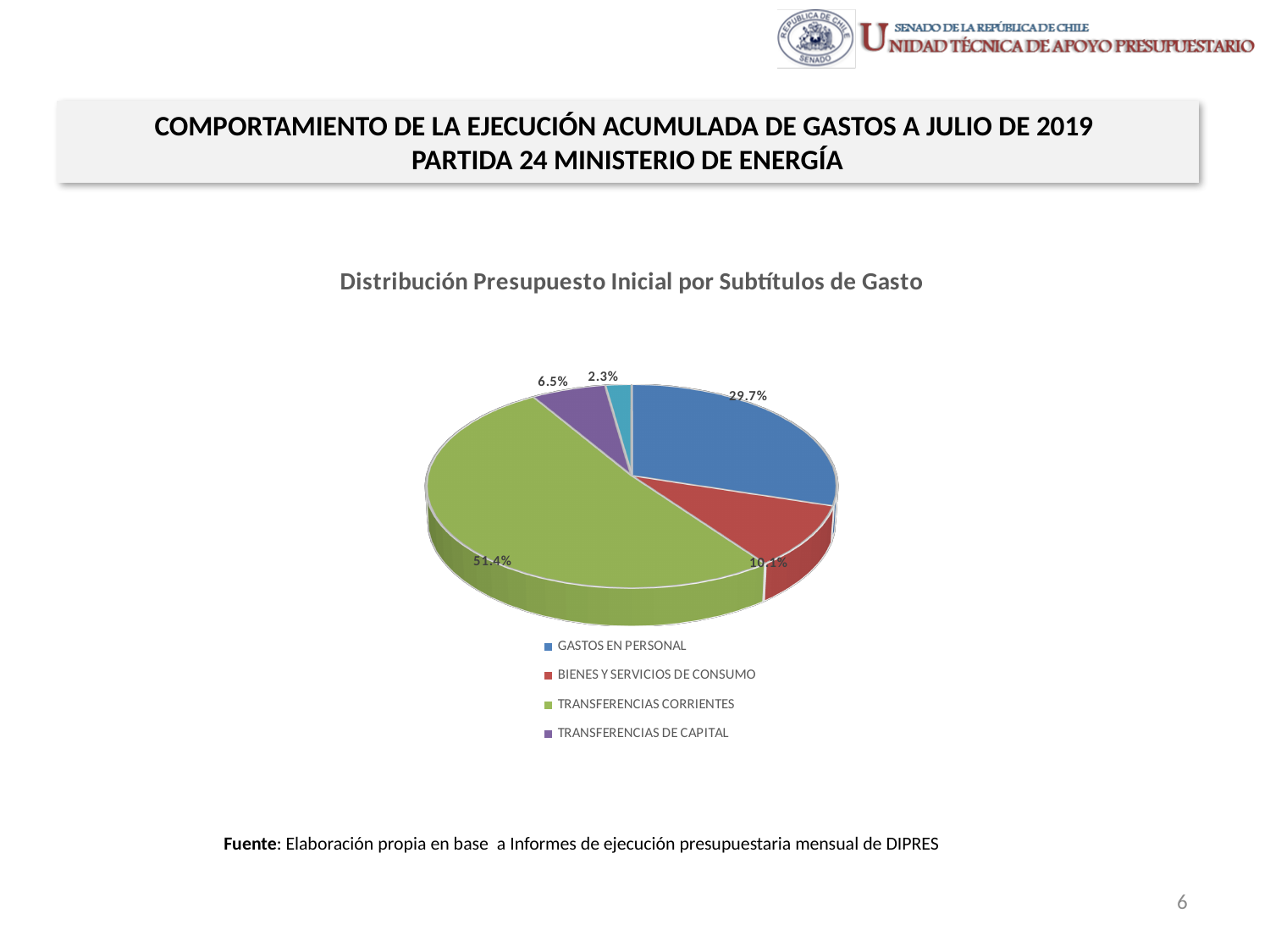
Which category has the largest slice of the pie? TRANSFERENCIAS CORRIENTES What percentage is shown for BIENES Y SERVICIOS DE CONSUMO? 10.1% What percentage of the pie does TRANSFERENCIAS CORRIENTES represent? 51.4% What kind of chart is shown on the slide? Pie chart What percentage of the pie does GASTOS EN PERSONAL represent? 29.7% Which is larger, the share for GASTOS EN PERSONAL or the share for BIENES Y SERVICIOS DE CONSUMO? GASTOS EN PERSONAL What is the smallest percentage value labelled on the pie chart? 2.3% What is the title of the chart? Distribución Presupuesto Inicial por Subtítulos de Gasto How many slices does the pie chart have? 5 What percentage is shown for TRANSFERENCIAS DE CAPITAL? 6.5% By how many percentage points does TRANSFERENCIAS CORRIENTES exceed GASTOS EN PERSONAL? 21.7 percentage points Does TRANSFERENCIAS CORRIENTES account for more or less than half of the pie? more